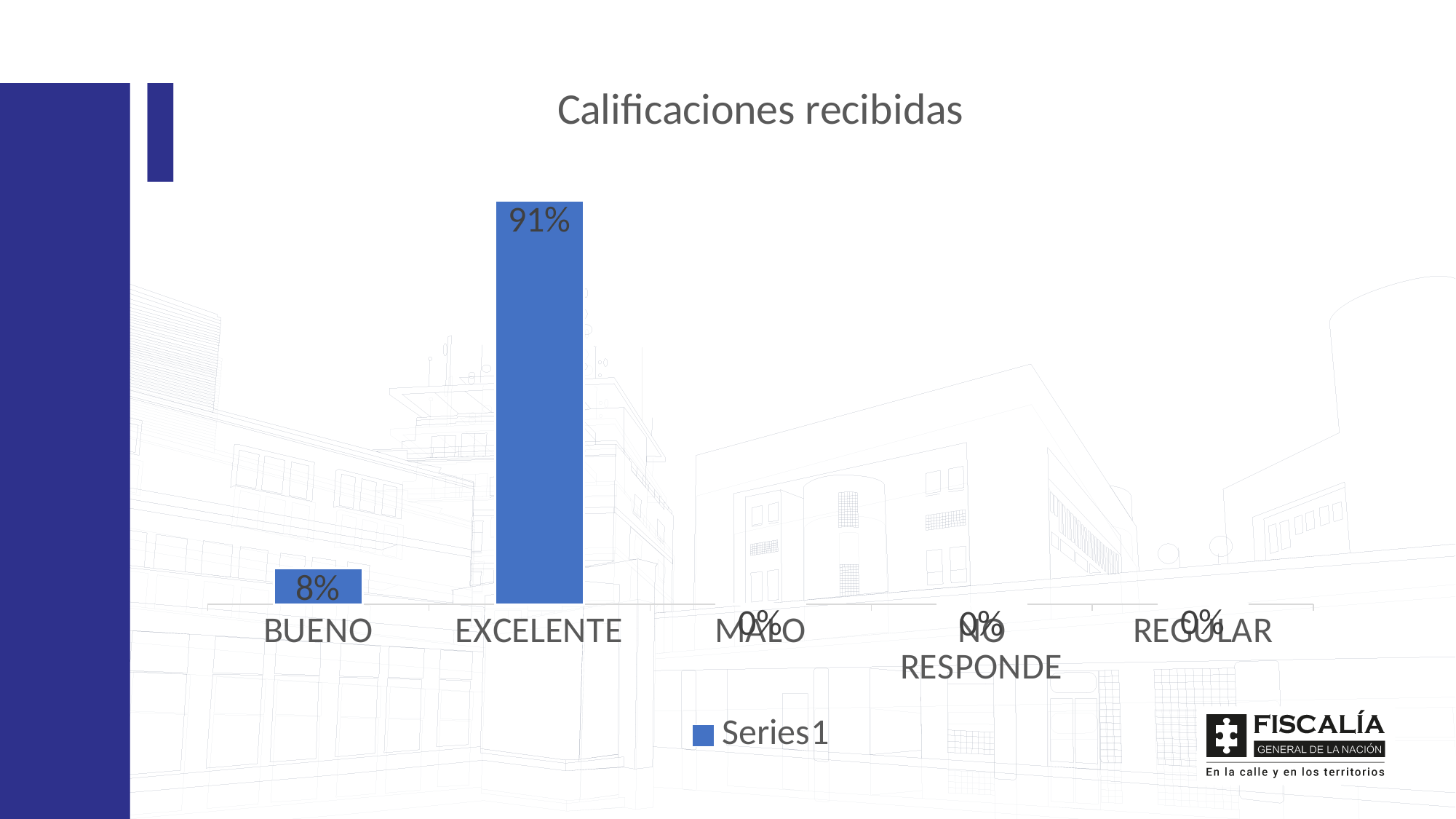
How many series does the legend list? 1 What is the value for EXCELENTE? 91% What is the value for BUENO? 8% Which is larger, the value for BUENO or the value for EXCELENTE? EXCELENTE What is the difference between the values for EXCELENTE and BUENO? 83% What is the value for REGULAR? 0% How many categories are shown on the x axis? 5 Which category has the highest value? EXCELENTE What kind of chart is shown? bar chart What is the value for MALO? 0% What is the title of the chart? Calificaciones recibidas What is the name of the series in the legend? Series1